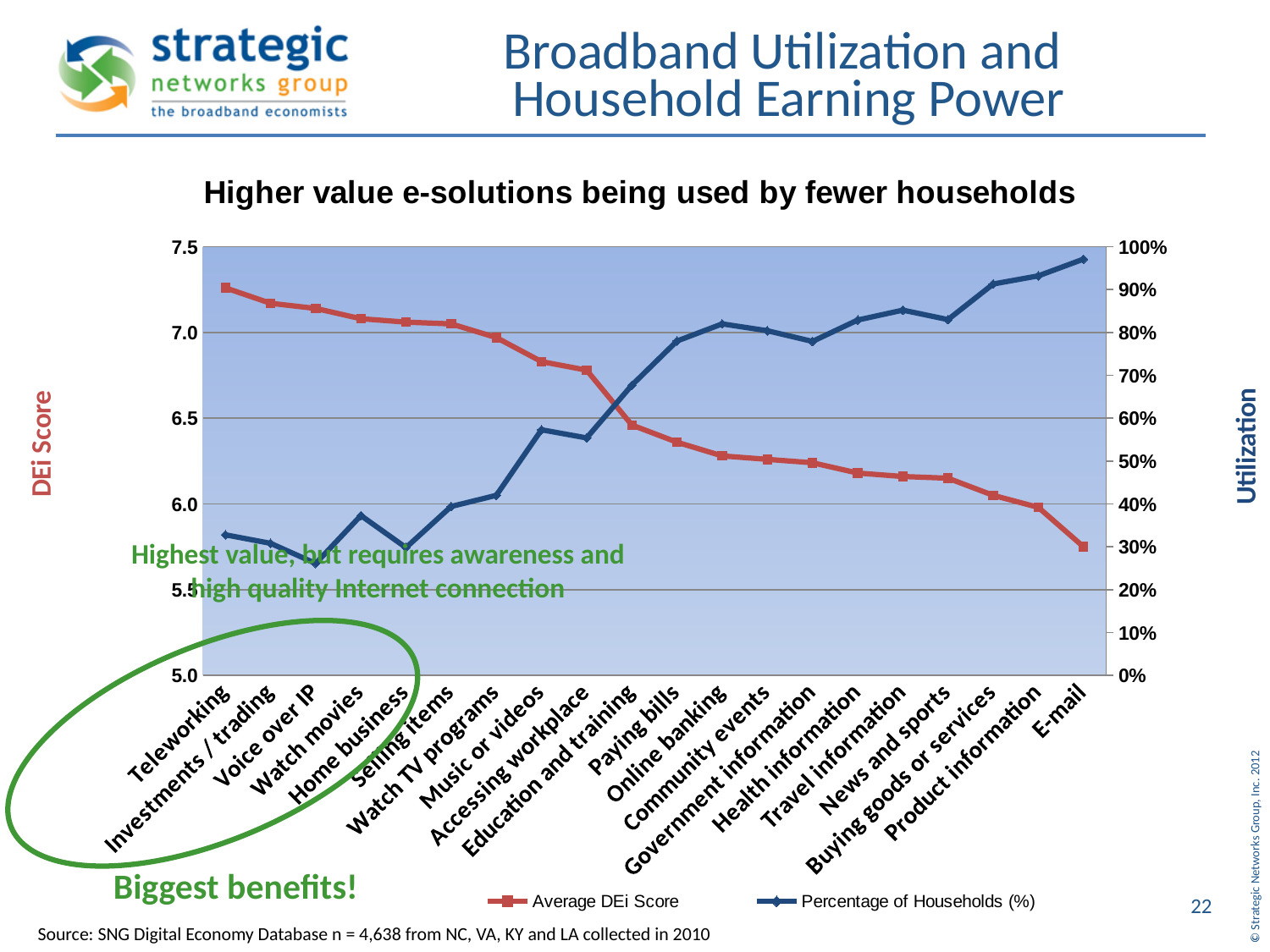
Is the Percentage of Households for Teleworking greater or less than 40%? less Is the Average DEi Score for Teleworking greater or less than 7.0? greater How many series does the chart legend list? 2 Is the Percentage of Households for E-mail greater or less than 90%? greater How many e-solution categories are plotted along the x axis? 20 What kind of chart is shown on the slide? Line chart Which category has the lowest Average DEi Score? E-mail Does the Average DEi Score rise or fall moving from Teleworking to E-mail along the x axis? Fall Which category has the highest Average DEi Score? Teleworking What is the title of the chart? Higher value e-solutions being used by fewer households Which category has the highest Percentage of Households? E-mail